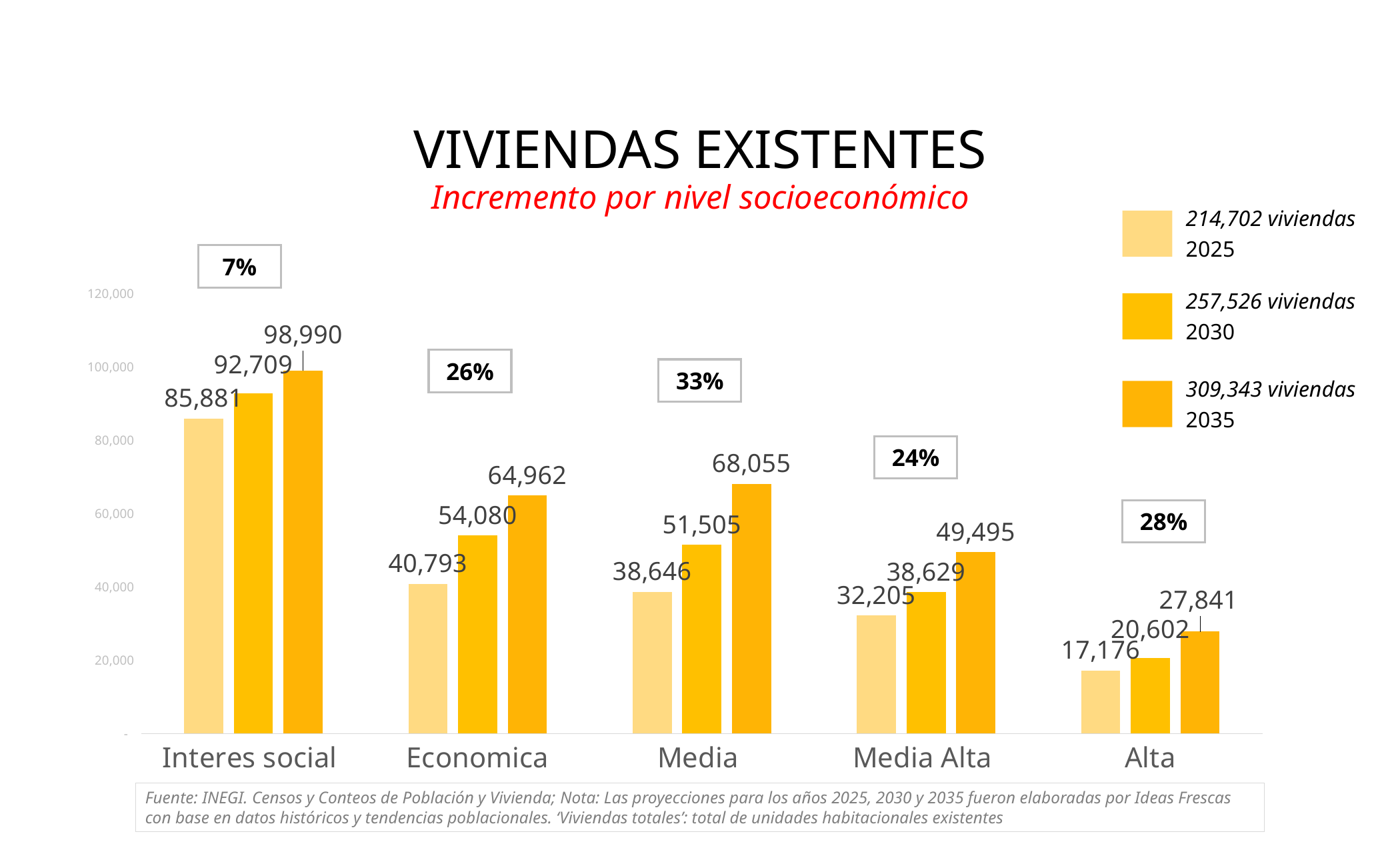
Which is larger, the 2030 value for Media or the 2030 value for Economica? Economica Which category has the highest value in 2035? Interes social How many categories are shown on the x axis? 5 Which category has the lowest value in 2025? Alta How many series does the legend list? 3 Is the 2035 value for Media Alta greater or less than 40,000? greater What is the value for Media in 2025? 38,646 What is the difference between the 2035 and 2025 values for Economica? 24,169 What is the value for Alta in 2030? 20,602 What kind of chart is shown? bar chart What percentage is shown in the box above the Media category? 33% What is the value for Interes social in 2035? 98,990